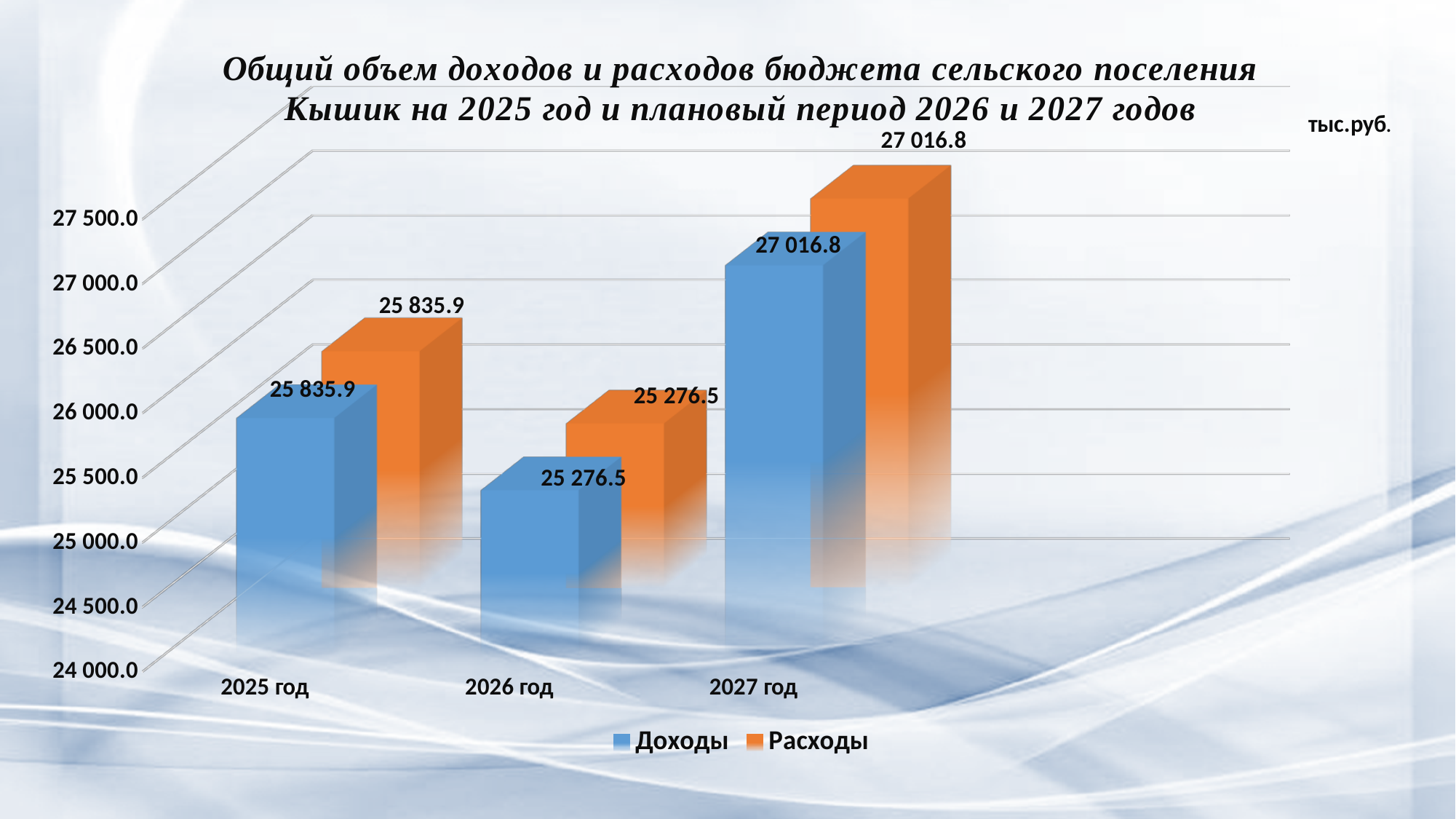
Which year has the lowest value of Расходы? 2026 год What is the value of Расходы for 2027 год? 27 016.8 What kind of chart is shown on the slide? Bar chart Which year has the highest value of Доходы? 2027 год What is the value of Расходы for 2026 год? 25 276.5 How many series does the legend list? 2 How many years are shown on the x axis? 3 What is the difference between Доходы in 2027 год and Доходы in 2025 год? 1 180.9 What is the value of Доходы for 2025 год? 25 835.9 What unit is indicated in the top right corner of the chart? тыс.руб. What is the value of Доходы for 2027 год? 27 016.8 Which is larger: Расходы in 2025 год or Расходы in 2026 год? 2025 год